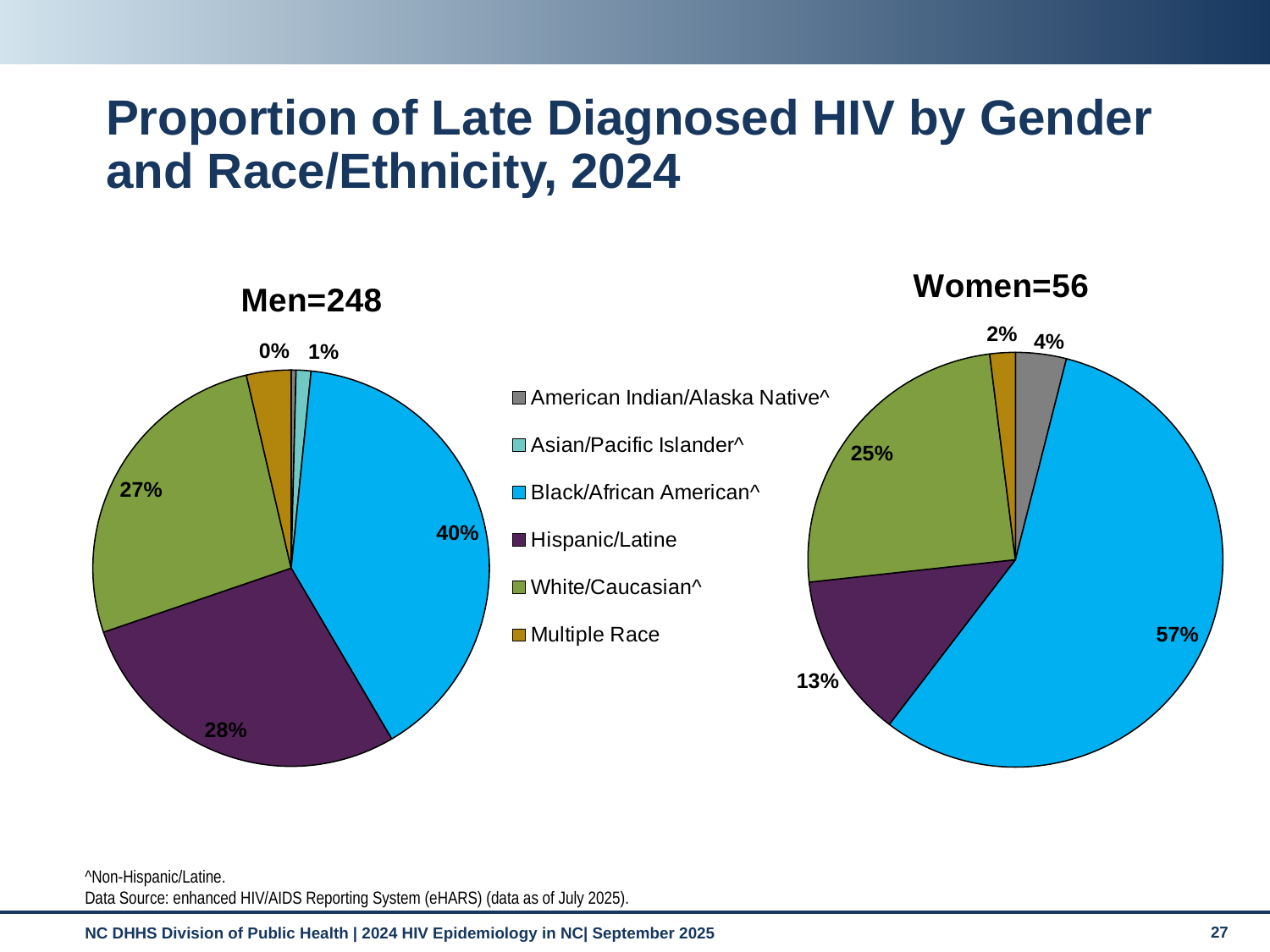
In the Women=56 pie chart, what percentage is Hispanic/Latine? 13% In the Women=56 pie chart, what percentage is American Indian/Alaska Native^? 4% Is the White/Caucasian^ share larger in the Men=248 chart or the Women=56 chart? Men=248 What type of charts are shown on the slide? Pie charts In the Men=248 pie chart, what percentage is Black/African American^? 40% In the Men=248 pie chart, what percentage is White/Caucasian^? 27% What is the difference between the Black/African American^ share in the Women=56 chart and in the Men=248 chart? 17 percentage points In the Women=56 pie chart, what percentage is Black/African American^? 57% In the Women=56 pie chart, which race/ethnicity has the largest share? Black/African American^ In the Men=248 pie chart, what percentage is Hispanic/Latine? 28% In the Men=248 pie chart, which race/ethnicity has the largest share? Black/African American^ How many race/ethnicity categories does the legend list? 6